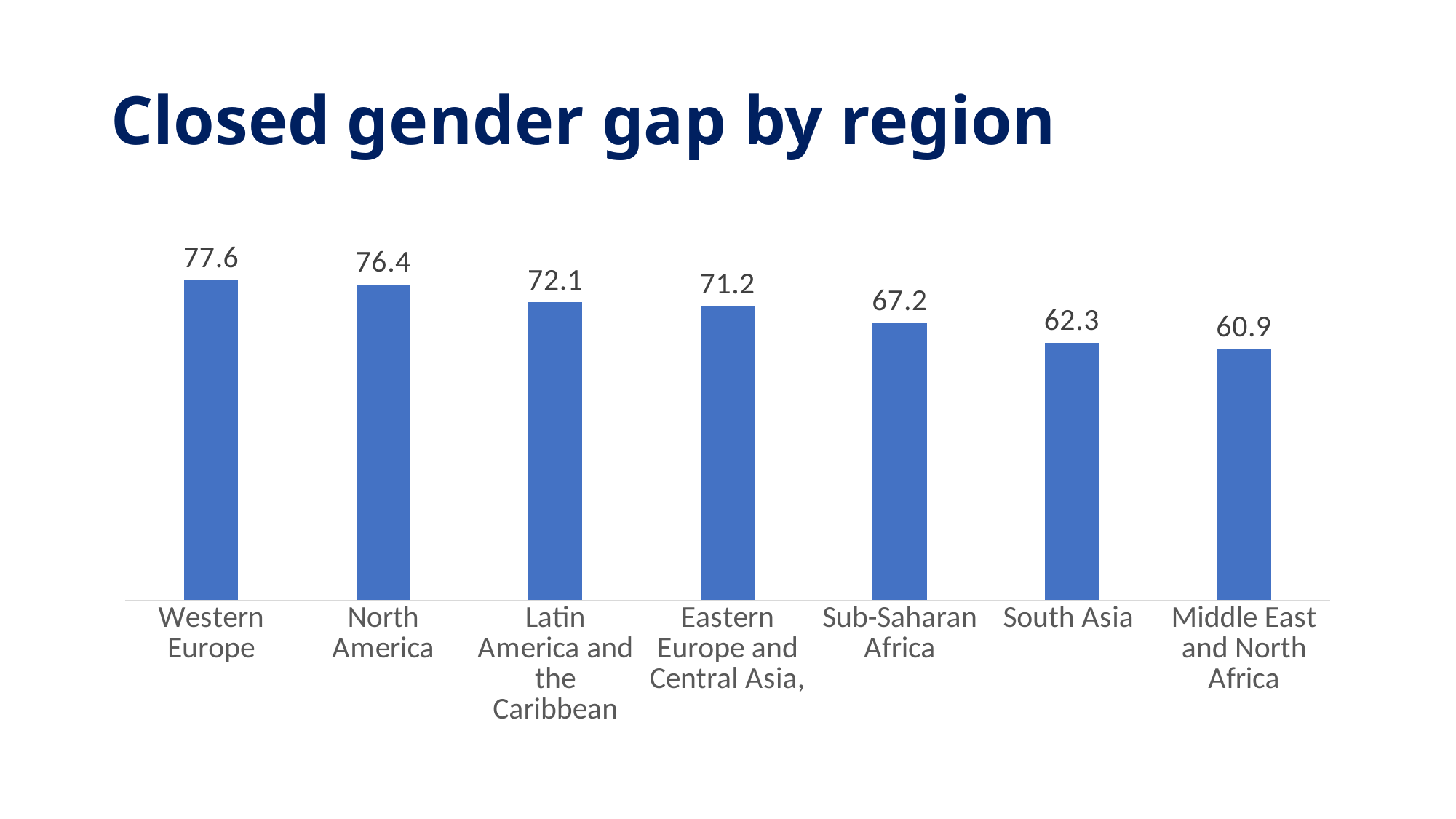
What is the difference between the values for Western Europe and Middle East and North Africa? 16.7 What is the value for Sub-Saharan Africa? 67.2 What kind of chart is shown on the slide? Bar chart Which region has the highest value? Western Europe What is the value for Western Europe? 77.6 What is the value for Middle East and North Africa? 60.9 Which region has the lowest value? Middle East and North Africa Which is larger, the value for Eastern Europe and Central Asia or the value for South Asia? Eastern Europe and Central Asia Do the values rise or fall from left to right across the regions? Fall What is the value for Latin America and the Caribbean? 72.1 What is the difference between the values for North America and South Asia? 14.1 How many regions are shown in the chart? 7